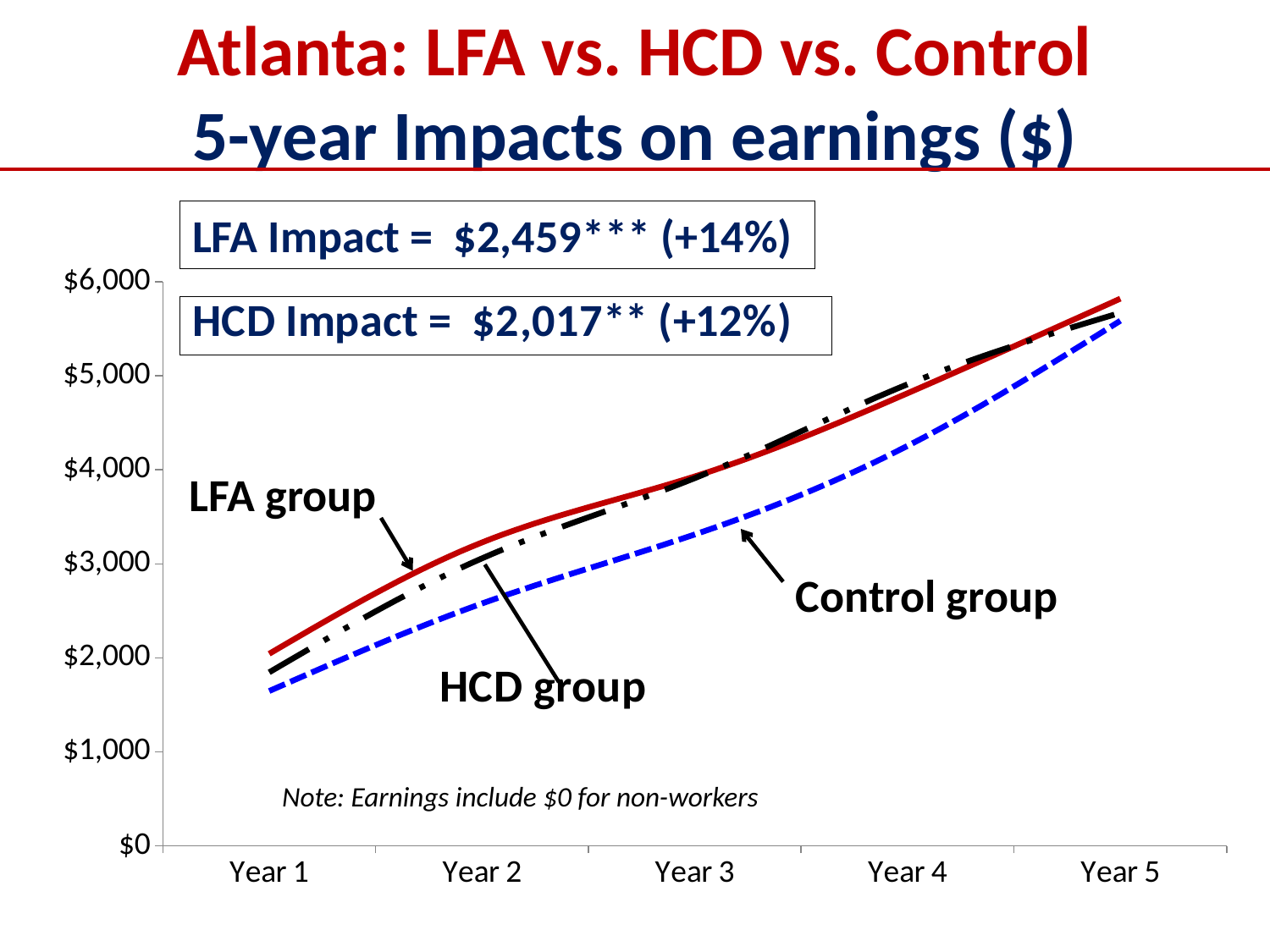
What kind of chart is shown on the slide? Line chart In Year 1, which has higher earnings: the LFA group or the Control group? LFA group Which group has the lowest earnings in Year 5? Control group Is the value for the LFA group in Year 5 greater or less than $5,000? greater Is the value for the HCD group in Year 4 greater or less than $4,000? greater Is the value for the Control group in Year 1 greater or less than $2,000? less What is the LFA Impact value stated on the slide? $2,459*** (+14%) What is the HCD Impact value stated on the slide? $2,017** (+12%) Do the earnings for the Control group rise or fall from Year 1 to Year 5? Rise How many years are shown along the x axis of the chart? 5 How many groups (series) are plotted on the chart? 3